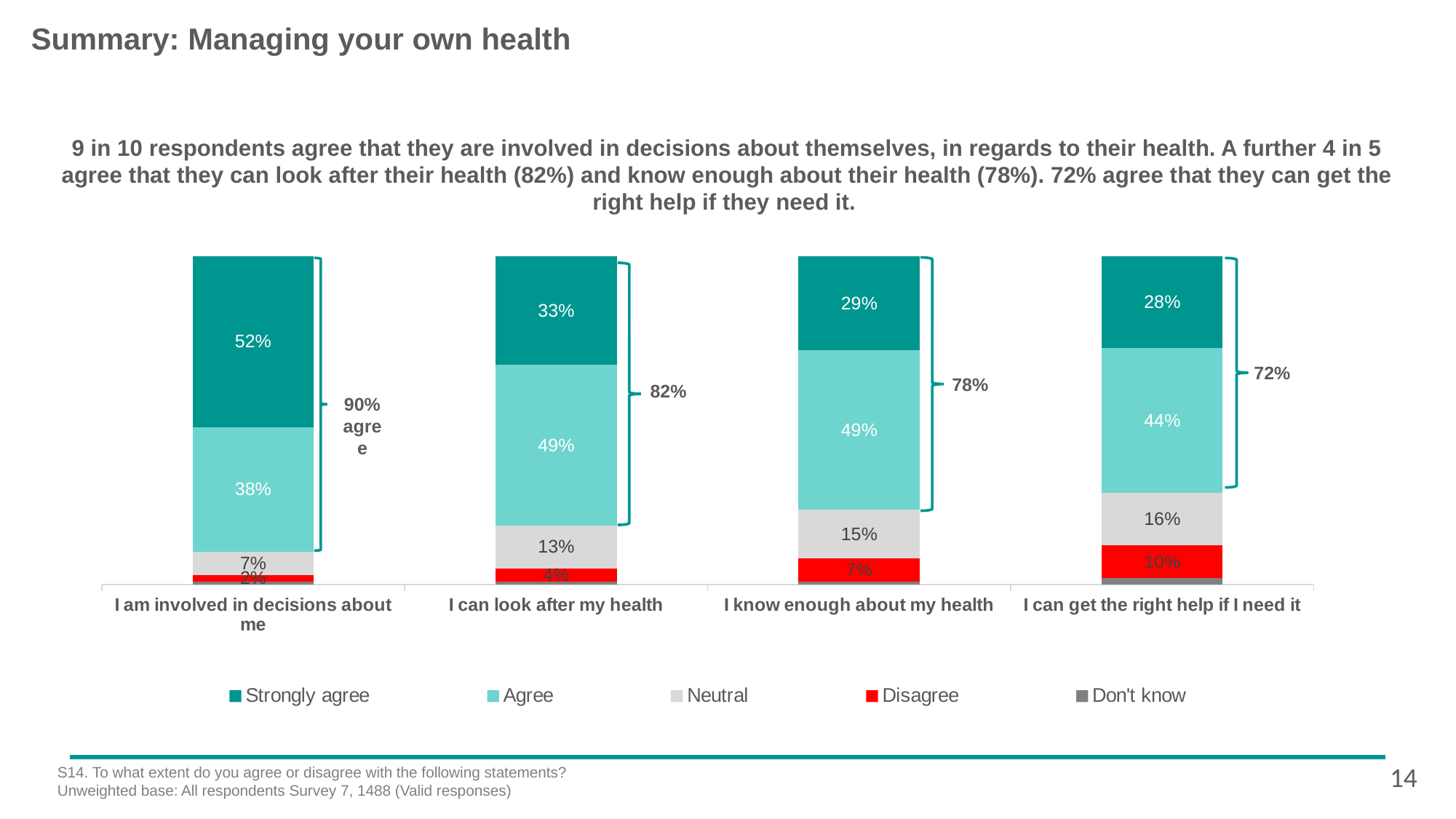
Which is larger: the 'Neutral' value for 'I can get the right help if I need it' or for 'I can look after my health'? I can get the right help if I need it What percentage of respondents strongly agree with 'I am involved in decisions about me'? 52% How many statements (categories) are shown on the x axis? 4 Which statement has the lowest 'Disagree' percentage? I am involved in decisions about me Which statement has the highest 'Strongly agree' percentage? I am involved in decisions about me How many series does the legend list? 5 What combined agreement percentage is shown by the bracket for 'I can look after my health'? 82% What is the 'Agree' value for 'I can look after my health'? 49% What is the 'Disagree' value for 'I can get the right help if I need it'? 10% What is the difference between the 'Strongly agree' values for 'I am involved in decisions about me' and 'I can get the right help if I need it'? 24 percentage points What is the 'Neutral' value for 'I know enough about my health'? 15% What type of chart is shown on the slide? Stacked bar chart